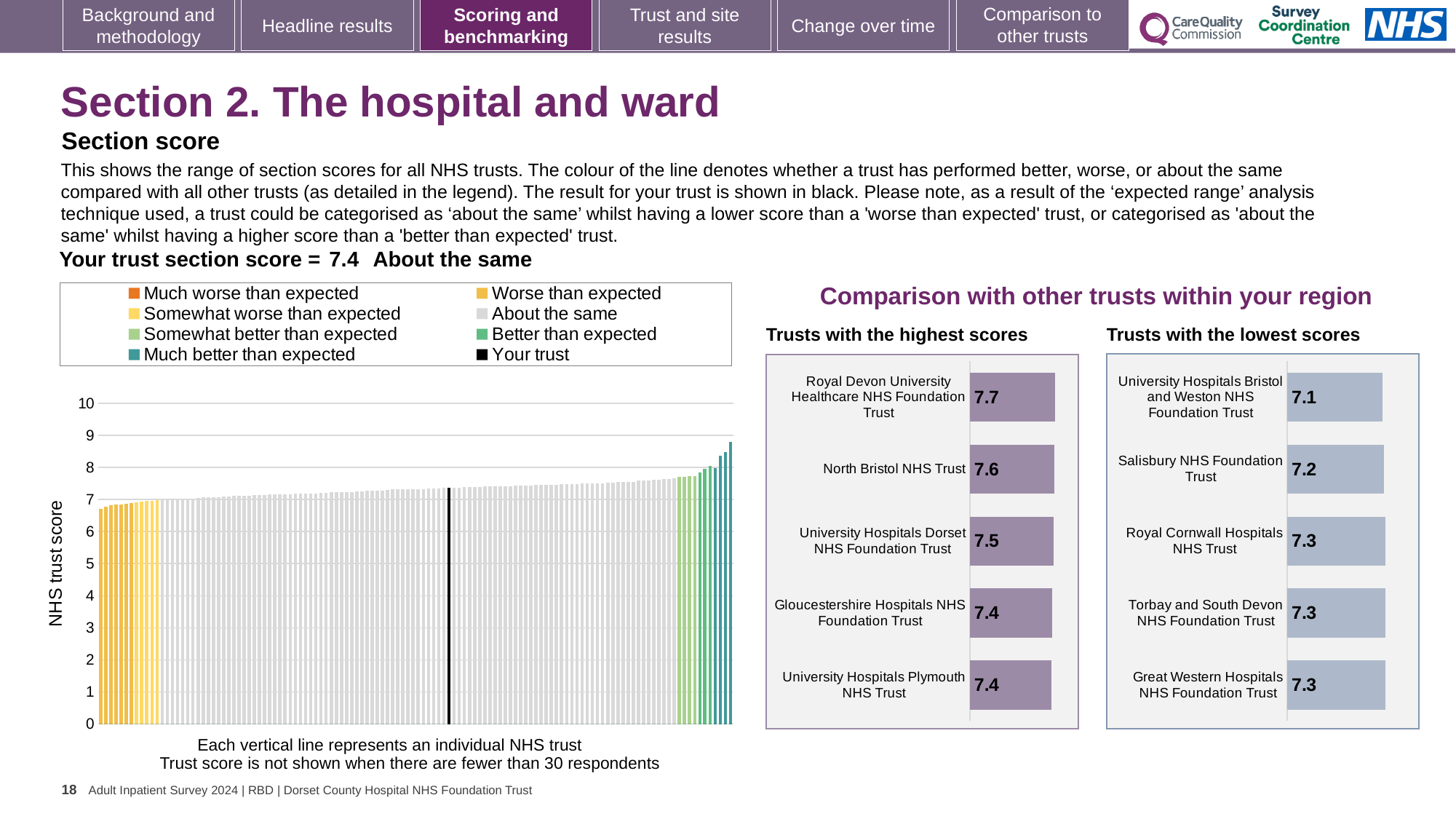
In the 'Trusts with the lowest scores' chart, which has the larger score: Salisbury NHS Foundation Trust or Royal Cornwall Hospitals NHS Trust? Royal Cornwall Hospitals NHS Trust In the large 'NHS trust score' chart, do the bar heights rise or fall from left to right? Rise In the 'Trusts with the lowest scores' chart, which trust has the lowest score? University Hospitals Bristol and Weston NHS Foundation Trust How many trusts are shown in the 'Trusts with the lowest scores' chart? 5 In the large 'NHS trust score' chart, is the value of the black 'Your trust' bar greater or less than 7? greater In the 'Trusts with the highest scores' chart, what is the score for Royal Devon University Healthcare NHS Foundation Trust? 7.7 In the 'Trusts with the lowest scores' chart, what is the score for Salisbury NHS Foundation Trust? 7.2 In the 'Trusts with the highest scores' chart, which trust has the highest score? Royal Devon University Healthcare NHS Foundation Trust What kind of chart is the large chart with the 'NHS trust score' axis? Bar chart In the 'Trusts with the highest scores' chart, what is the difference between the scores of Royal Devon University Healthcare NHS Foundation Trust and University Hospitals Dorset NHS Foundation Trust? 0.2 In the 'Trusts with the highest scores' chart, what is the score for University Hospitals Dorset NHS Foundation Trust? 7.5 How many entries does the legend of the large 'NHS trust score' chart list? 8